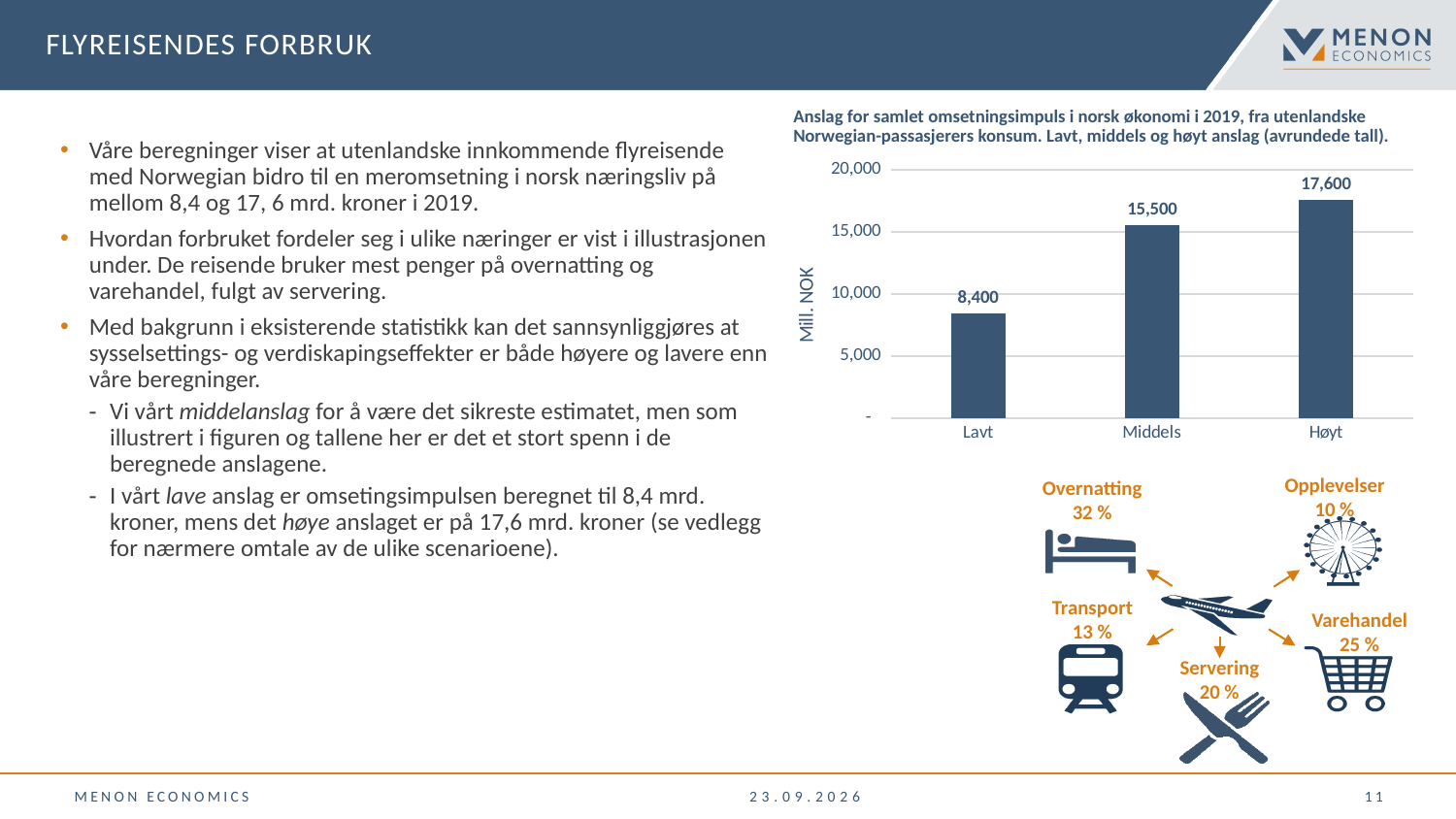
Which category has the lowest value in the bar chart? Lavt How many categories are shown on the x axis of the bar chart? 3 Which category has the highest value in the bar chart? Høyt Which is larger, the value for Middels or the value for Lavt? Middels What is the value for Lavt in the bar chart? 8,400 What is the difference between the values for Høyt and Middels? 2,100 What is the value for Middels in the bar chart? 15,500 What is the value for Høyt in the bar chart? 17,600 What kind of chart is shown on the slide? bar chart Is the value for Lavt greater or less than 10,000? less What is the difference between the values for Høyt and Lavt? 9,200 What is the label on the y axis of the bar chart? Mill. NOK